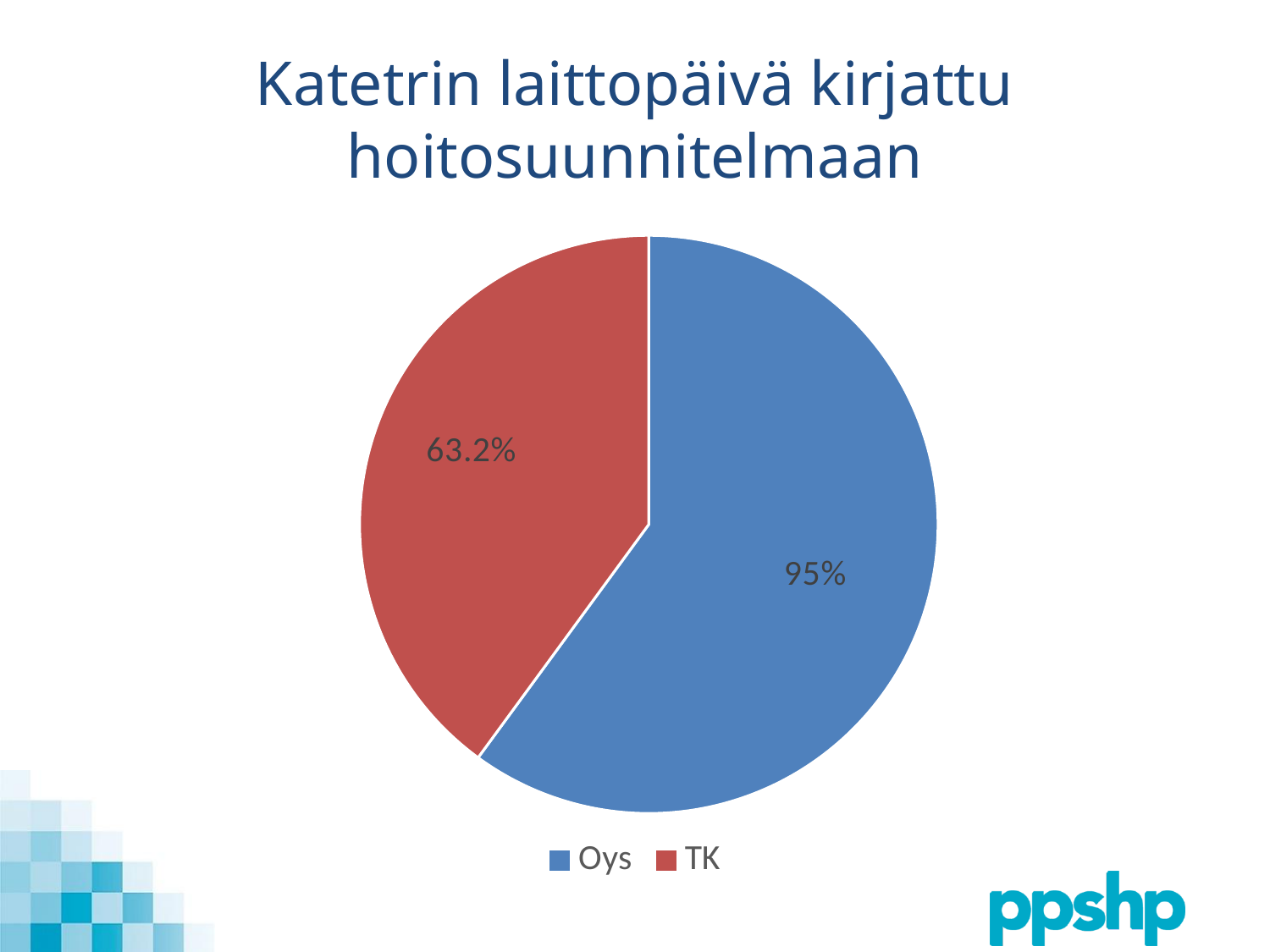
Which slice occupies the larger area of the pie? Oys How many slices does the pie chart have? 2 What is the title of the chart on the slide? Katetrin laittopäivä kirjattu hoitosuunnitelmaan What colour is the slice for TK? Red What value is shown for TK in the pie chart? 63.2% What value is shown for Oys in the pie chart? 95% Which is larger, the value for Oys or the value for TK? Oys Which category has the highest value in the pie chart? Oys What kind of chart is shown on the slide? Pie chart What is the difference between the value for Oys and the value for TK? 31.8 percentage points How many entries does the legend list? 2 Which category has the lowest value in the pie chart? TK